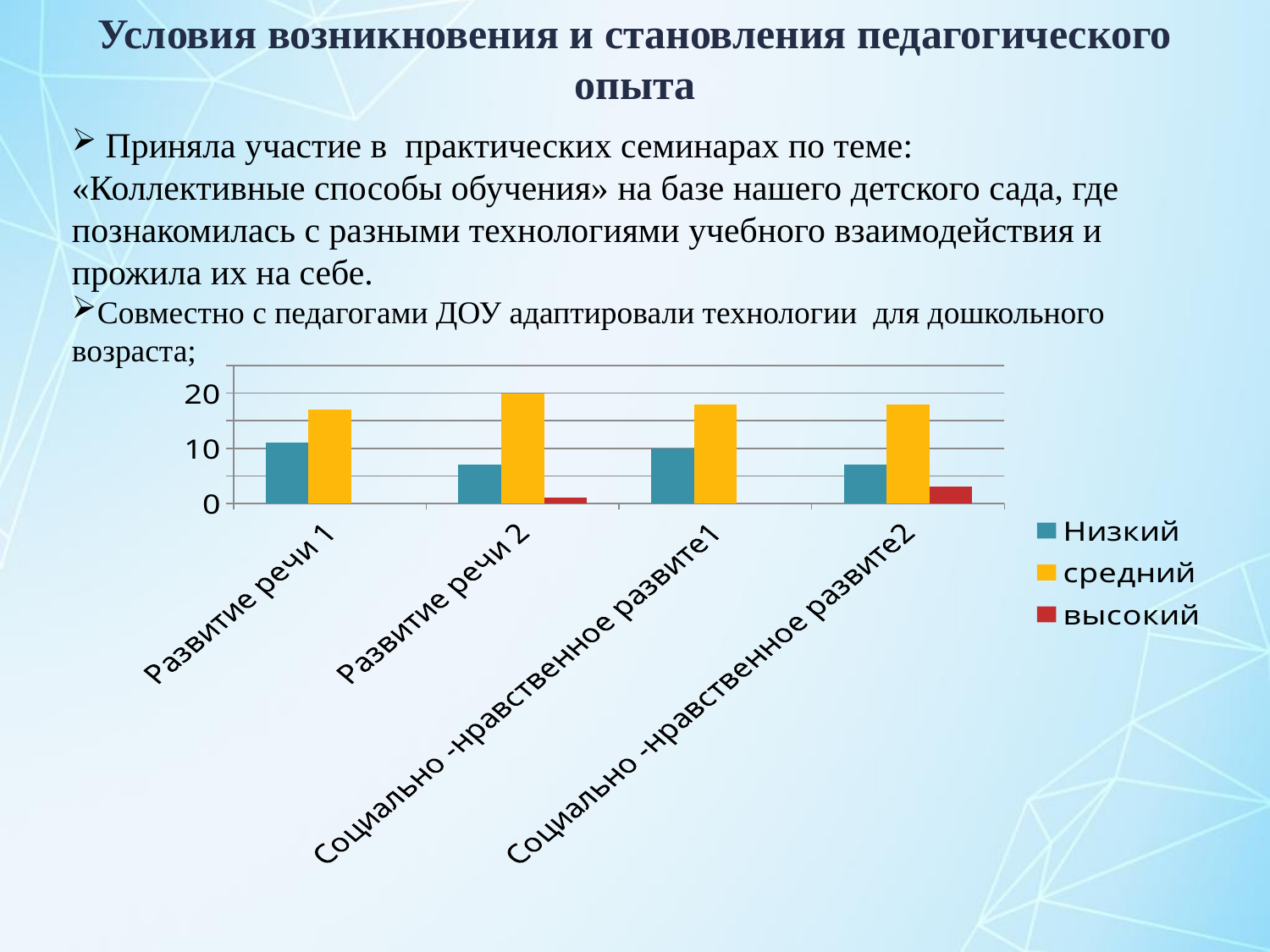
How many categories are shown on the x axis of the chart? 4 Is the value of the средний series for Социально -нравственное развите1 greater or less than 10? greater Which series is shown in red in the chart? высокий Is the value of the Низкий series for Развитие речи 2 greater or less than 10? less How many series does the chart legend list? 3 Is the value of the высокий series for Социально -нравственное развите2 greater or less than 10? less What kind of chart is shown on the slide? bar chart For Развитие речи 1, which is larger: the Низкий value or the средний value? средний Which category has the highest value for the высокий series? Социально -нравственное развите2 Which is larger: the Низкий value for Развитие речи 1 or the Низкий value for Развитие речи 2? Развитие речи 1 Which category has the highest value for the средний series? Развитие речи 2